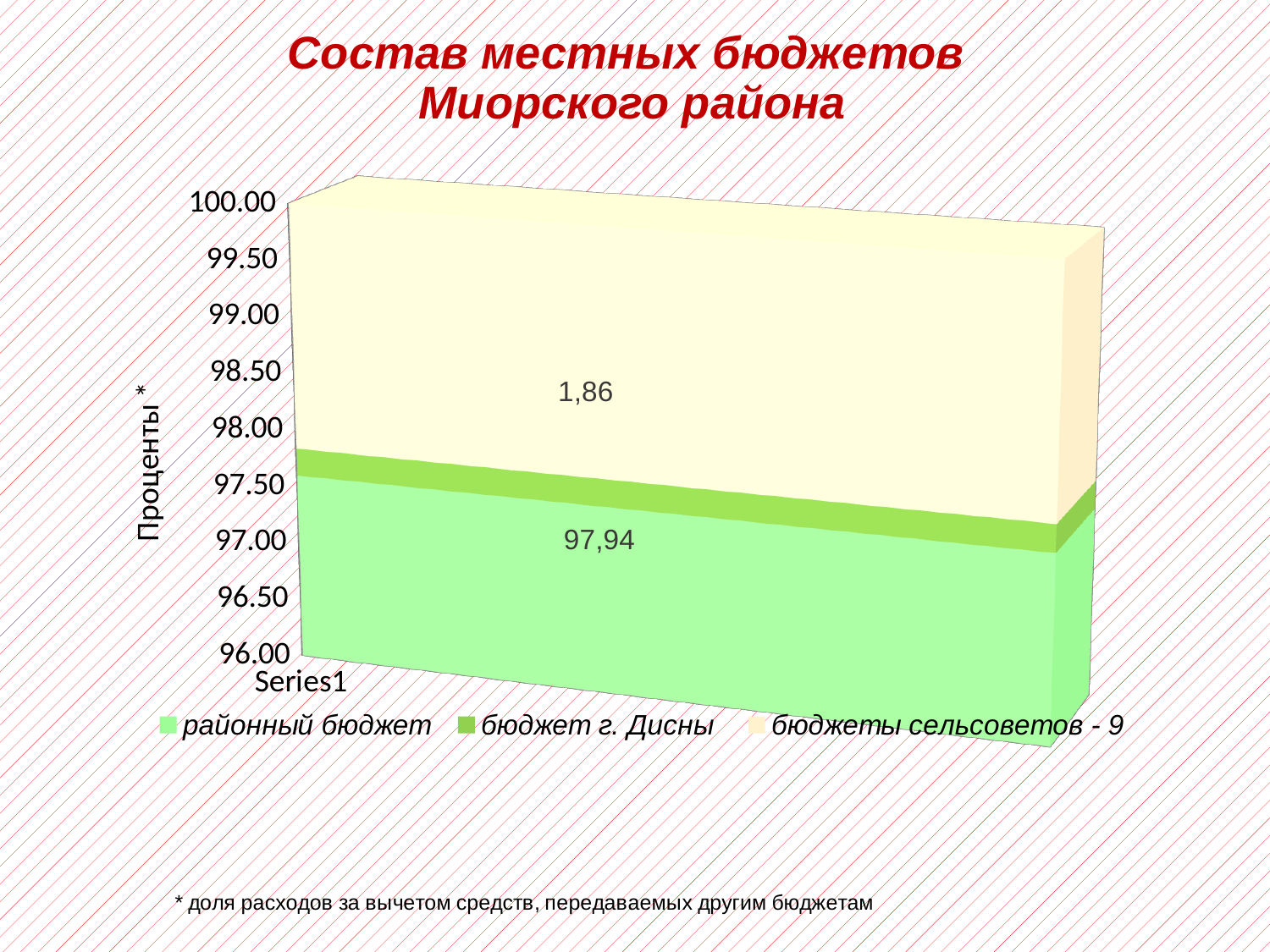
What is the value shown for бюджеты сельсоветов - 9? 1,86 What is the difference between the value for районный бюджет and the value for бюджеты сельсоветов - 9? 96,08 What is the label of the single category on the x axis? Series1 Which series has the smallest segment in the stacked bar? бюджет г. Дисны How many series does the legend list? 3 What is the label of the vertical axis? Проценты * What is the value shown for районный бюджет? 97,94 What kind of chart is shown on the slide? Stacked area chart (3D) Which series has the largest segment in the stacked bar? районный бюджет Which is larger, the value for районный бюджет or the value for бюджеты сельсоветов - 9? районный бюджет